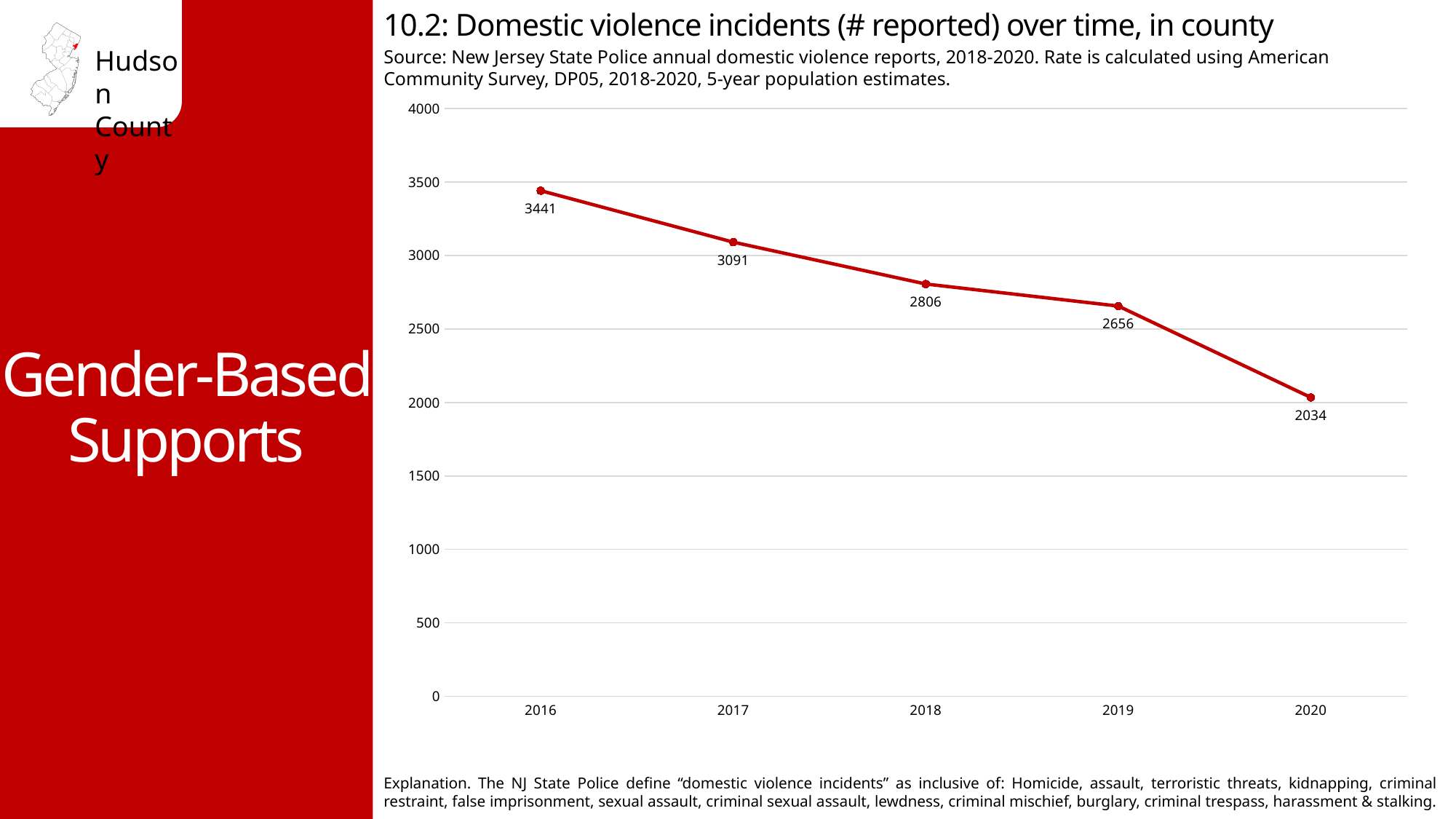
Is the value for 2018 greater or less than 3000? less What is the difference between the number of incidents in 2016 and 2020? 1407 How many years are plotted on the chart? 5 Which year has the highest number of reported domestic violence incidents? 2016 Do the reported domestic violence incidents rise or fall from 2016 to 2020? fall By how much did reported incidents fall from 2019 to 2020? 622 What kind of chart is shown on the slide? line chart What value is shown for 2020? 2034 Which year had more reported incidents, 2017 or 2019? 2017 How many domestic violence incidents were reported in 2016? 3441 Which year has the lowest number of reported domestic violence incidents? 2020 What is the number of reported domestic violence incidents for 2018? 2806